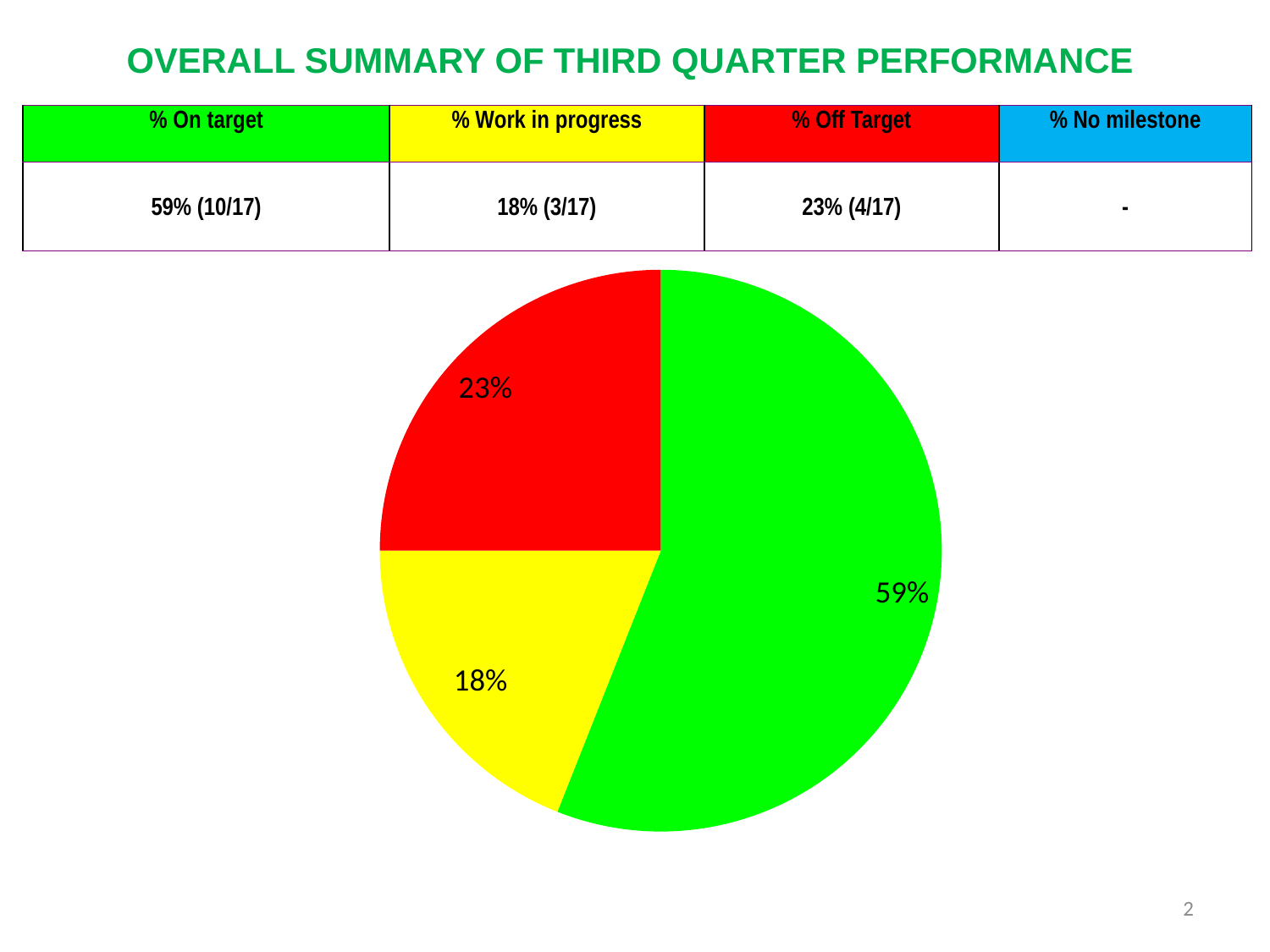
What percentage is shown on the red slice of the pie chart? 23% Is the green slice of the pie chart greater or less than 50%? greater What percentage is shown on the yellow slice of the pie chart? 18% How many slices does the pie chart have? 3 What is the difference in percentage points between the red slice and the yellow slice of the pie chart? 5 Which slice of the pie chart is the largest? the green slice (59%) Which is larger in the pie chart, the red slice or the yellow slice? the red slice What percentage is shown on the green slice of the pie chart? 59% What kind of chart is shown on the slide? pie chart Which colour is used for the largest slice of the pie chart? green What is the difference in percentage points between the green slice and the red slice of the pie chart? 36 Which slice of the pie chart is the smallest? the yellow slice (18%)